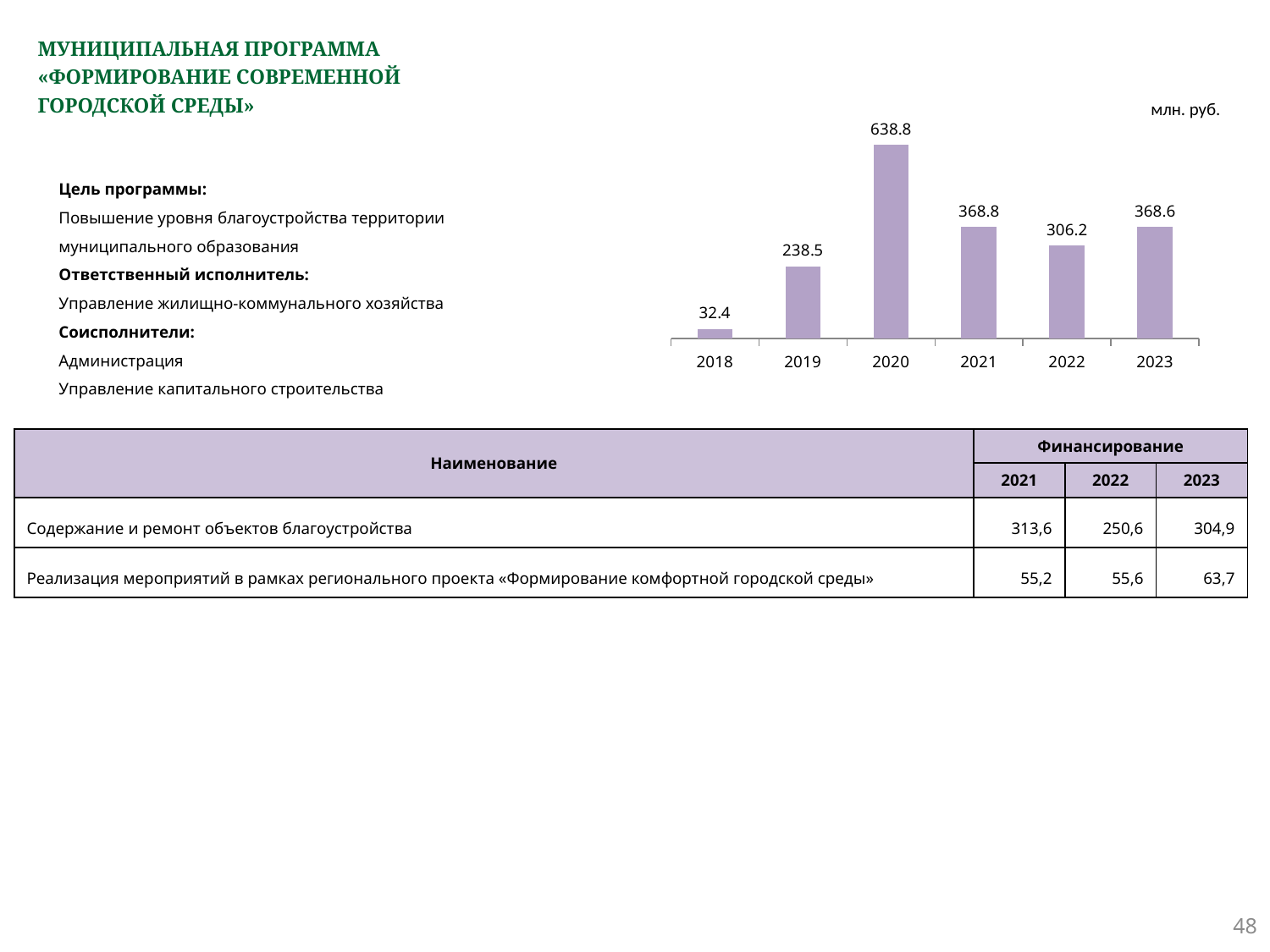
What is the difference between the values for 2020 and 2019 in the bar chart? 400.3 How many years are shown on the x axis of the bar chart? 6 What is the value for 2020 in the bar chart? 638.8 Which year has the highest value in the bar chart? 2020 Which is larger in the bar chart, the value for 2019 or the value for 2022? 2022 Does the value rise or fall from 2018 to 2020 in the bar chart? rise What is the value for 2018 in the bar chart? 32.4 What unit is indicated for the values in the bar chart? млн. руб. What is the value for 2022 in the bar chart? 306.2 Which year has the lowest value in the bar chart? 2018 What is the difference between the values for 2021 and 2022 in the bar chart? 62.6 What kind of chart is shown on the slide? bar chart